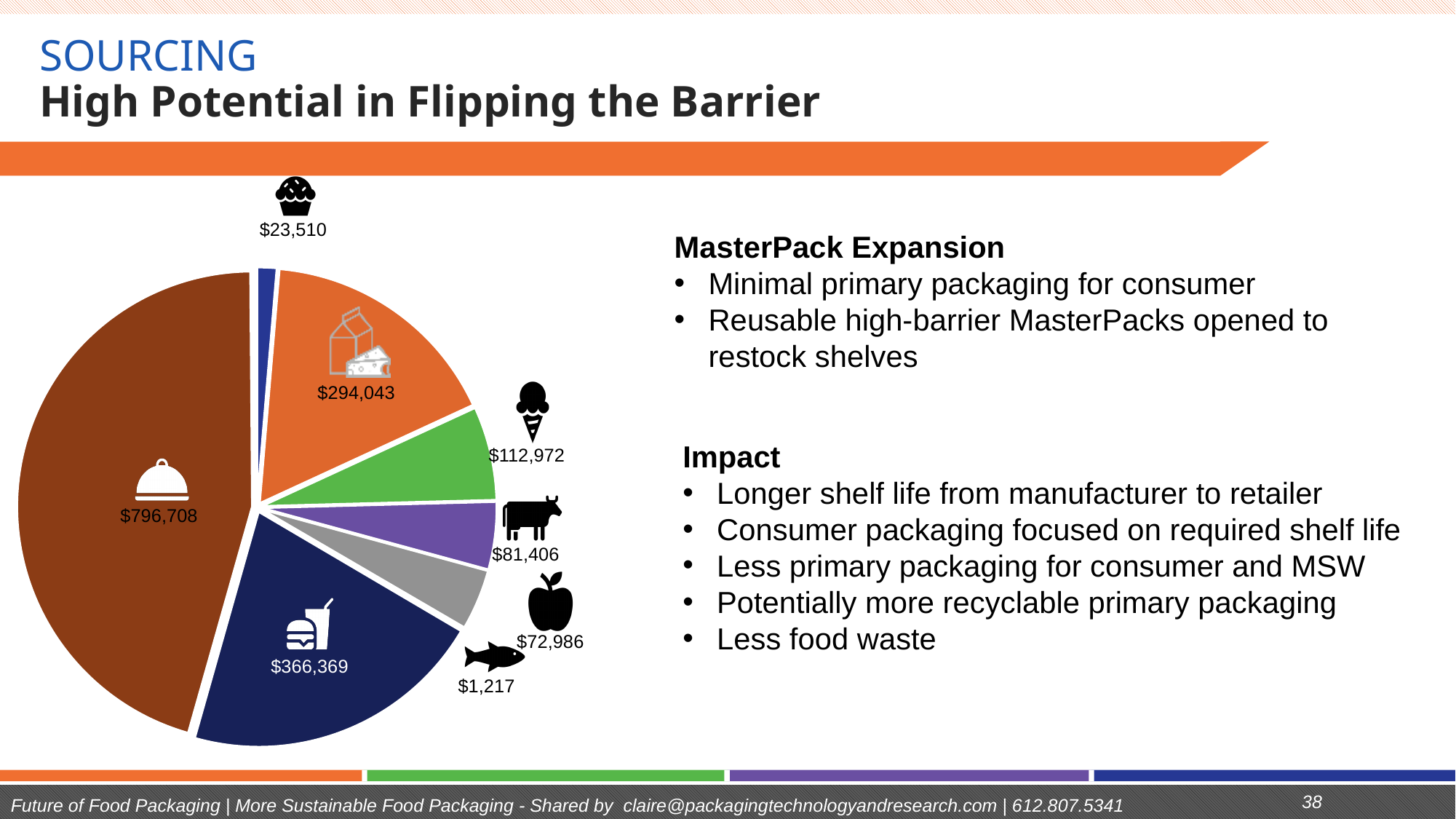
What kind of chart is shown on the slide? pie chart What value is shown for the green slice with the ice cream icon? $112,972 Which is larger, the orange slice with the dairy icon or the green slice with the ice cream icon? the orange slice with the dairy icon What is the value of the largest slice of the pie chart (the brown slice with the serving-dish icon)? $796,708 What value is shown for the purple slice with the cow icon? $81,406 What value is shown for the orange slice with the milk carton and cheese icon? $294,043 What is the difference between the brown slice ($796,708) and the navy blue slice ($366,369)? $430,339 What value is shown for the slice with the cupcake icon? $23,510 What is the value of the smallest slice of the pie chart (the slice with the fish icon)? $1,217 What is the difference between the purple slice with the cow icon and the gray slice with the apple icon? $8,420 What value is shown for the navy blue slice with the burger and drink icon? $366,369